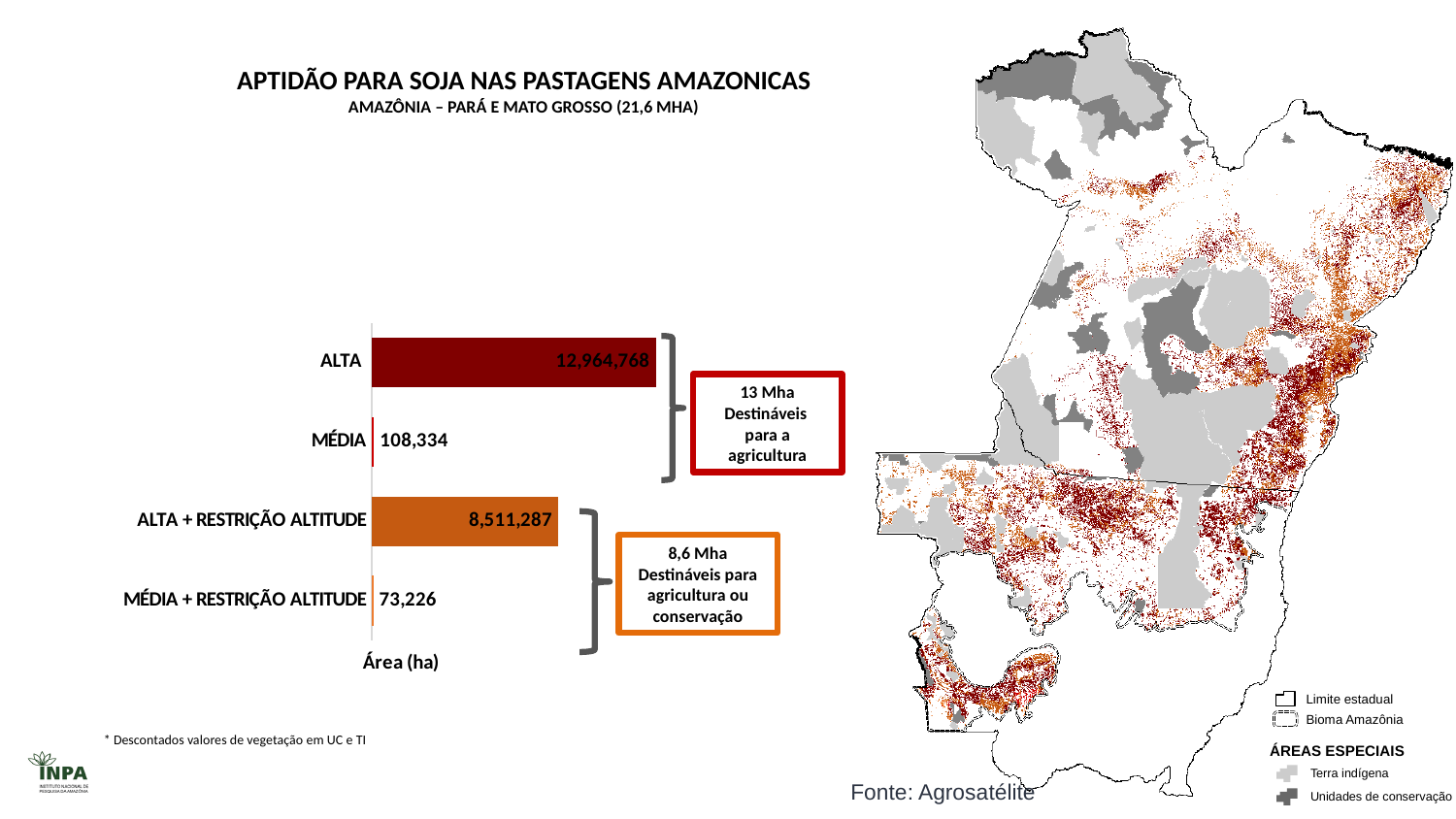
What is the axis label shown below the bars in the chart? Área (ha) What is the difference between the values for ALTA and ALTA + RESTRIÇÃO ALTITUDE? 4,453,481 What is the value for ALTA in the bar chart? 12,964,768 What is the value for MÉDIA + RESTRIÇÃO ALTITUDE in the bar chart? 73,226 Which is larger, the value for MÉDIA or the value for MÉDIA + RESTRIÇÃO ALTITUDE? MÉDIA What is the value for ALTA + RESTRIÇÃO ALTITUDE in the bar chart? 8,511,287 What is the difference between the values for MÉDIA and MÉDIA + RESTRIÇÃO ALTITUDE? 35,108 Which category has the highest value in the bar chart? ALTA What kind of chart is shown on the slide? Bar chart What is the value for MÉDIA in the bar chart? 108,334 How many categories are shown in the bar chart? 4 Which category has the lowest value in the bar chart? MÉDIA + RESTRIÇÃO ALTITUDE